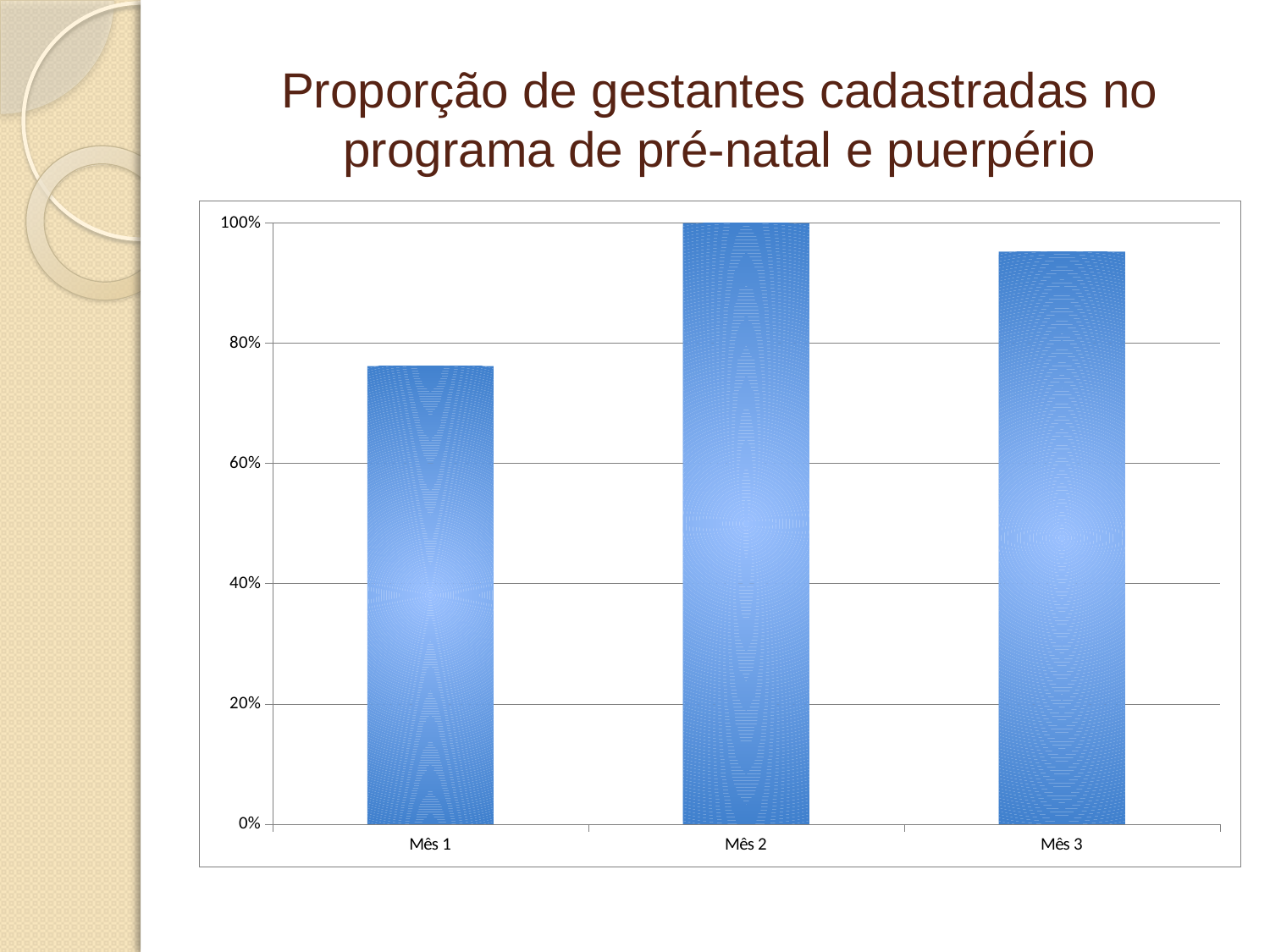
What is the title of the slide containing the chart? Proporção de gestantes cadastradas no programa de pré-natal e puerpério Which is larger, the value for Mês 1 or the value for Mês 3? Mês 3 Which month has the highest bar? Mês 2 Which is larger, the value for Mês 2 or the value for Mês 3? Mês 2 What is the value for Mês 2? 100% Is the value for Mês 1 greater or less than 80%? less What is the highest value shown on the y axis? 100% Is the value for Mês 1 greater or less than 60%? greater Is the value for Mês 3 greater or less than 80%? greater How many categories are plotted on the x axis? 3 Which month has the lowest bar? Mês 1 What kind of chart is shown on the slide? bar chart